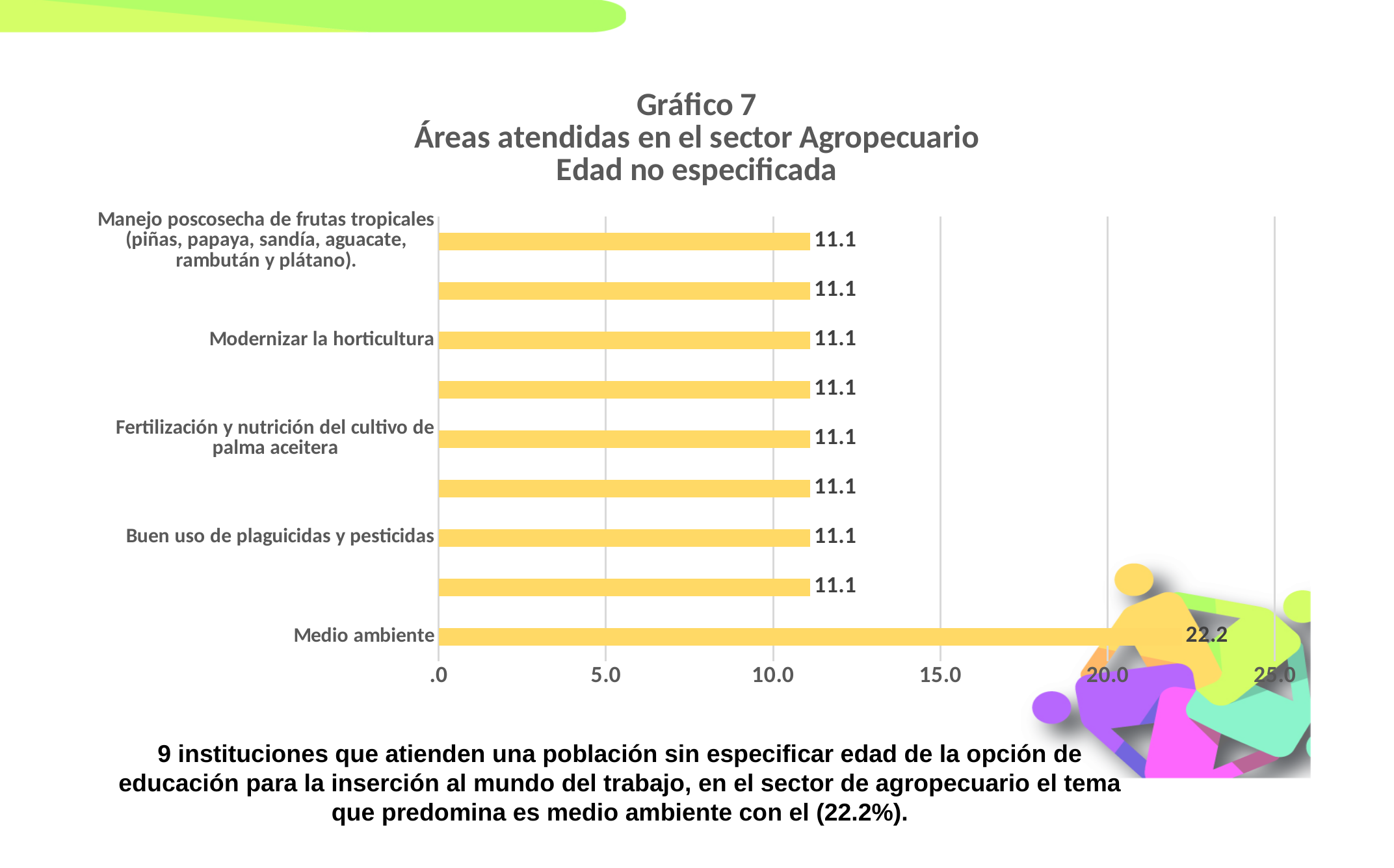
What type of chart is shown on the slide? bar chart How many bars are plotted in the chart? 9 What is the value for Modernizar la horticultura? 11.1 What is the value for Manejo poscosecha de frutas tropicales (piñas, papaya, sandía, aguacate, rambután y plátano)? 11.1 What is the difference between the value for Medio ambiente and the value for Modernizar la horticultura? 11.1 What is the value for Medio ambiente? 22.2 Which category has the highest value? Medio ambiente What is the value for Fertilización y nutrición del cultivo de palma aceitera? 11.1 Which is larger, the value for Medio ambiente or the value for Buen uso de plaguicidas y pesticidas? Medio ambiente What is the title of the chart? Gráfico 7 Áreas atendidas en el sector Agropecuario Edad no especificada Is the value for Medio ambiente greater or less than 20.0? greater What is the value for Buen uso de plaguicidas y pesticidas? 11.1